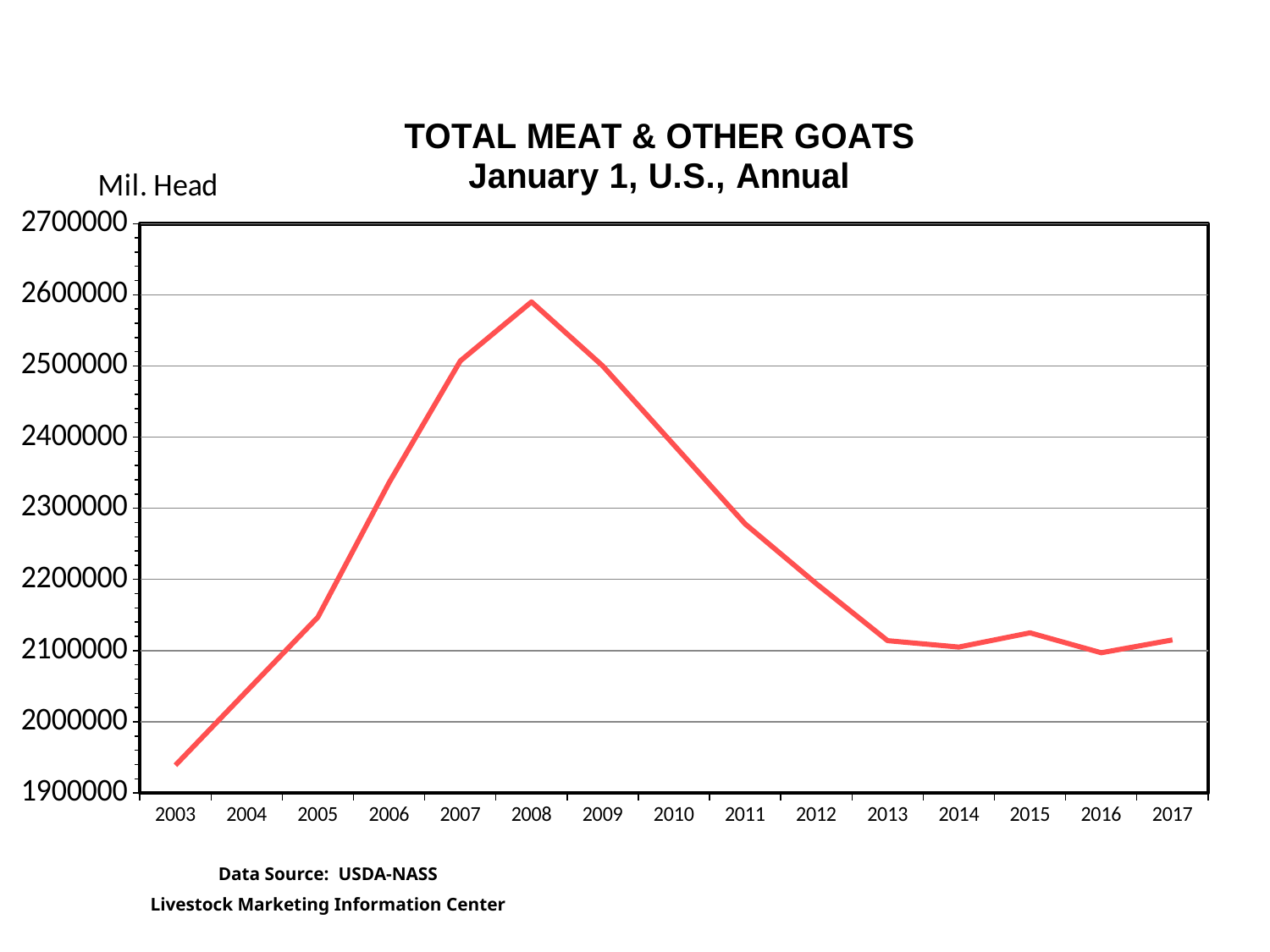
How many years are plotted on the x axis? 15 Which year has the larger value, 2005 or 2011? 2011 Do the values rise or fall from 2008 to 2013? Fall Is the value for 2003 greater or less than 2000000? less Is the value for 2006 greater or less than 2300000? greater Do the values rise or fall from 2003 to 2008? Rise What kind of chart is shown on the slide? Line chart In which year is the total meat & other goats value lowest? 2003 What is the label shown on the y axis of the chart? Mil. Head Is the value for 2008 greater or less than 2500000? greater In which year is the total meat & other goats value highest? 2008